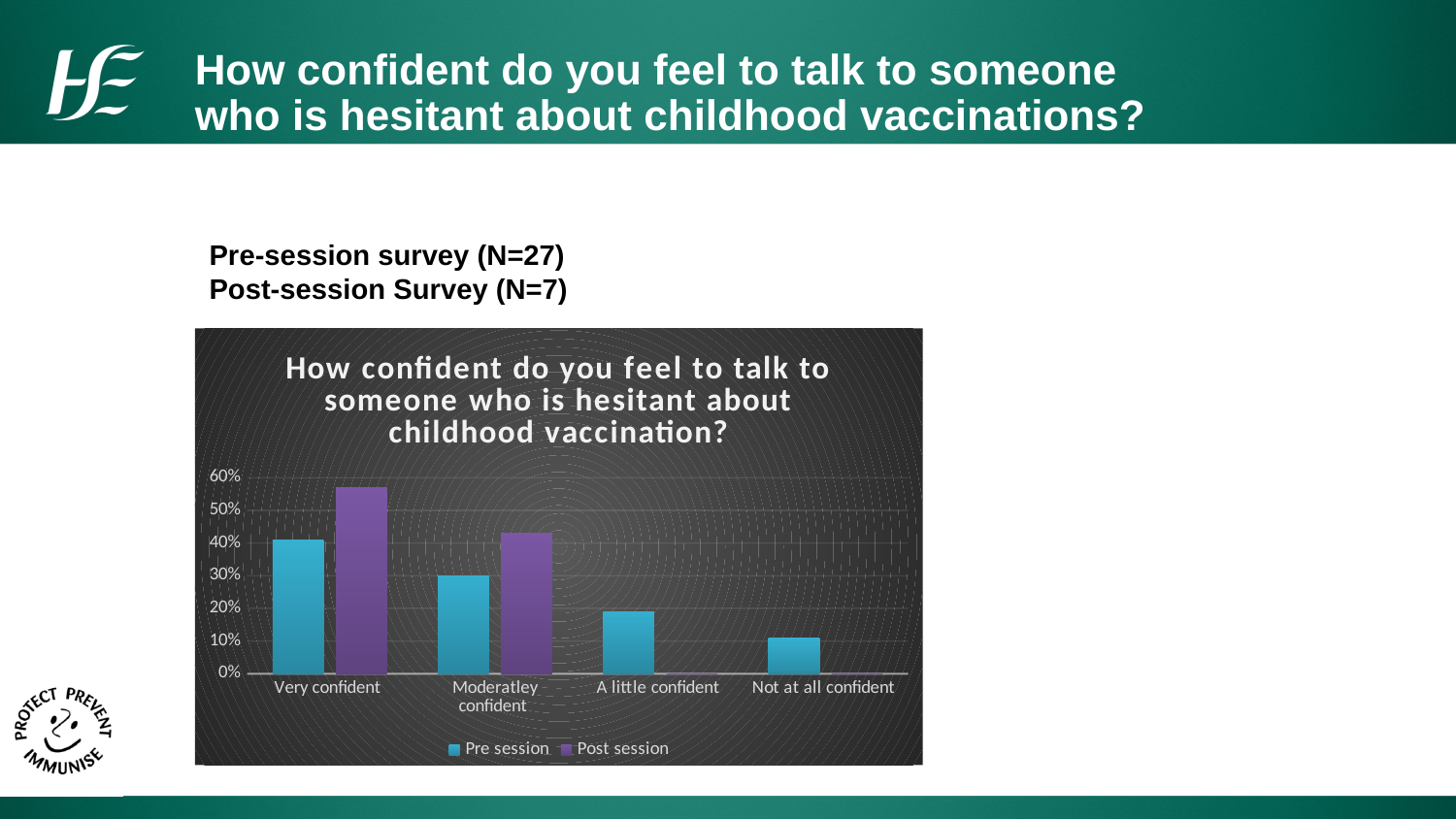
For the Very confident category, which series has the larger value, Pre session or Post session? Post session Which category has the lowest Pre session value? Not at all confident How many categories are shown on the x axis of the chart? 4 Is the Post session value for Moderatley confident greater or less than 40%? greater What are the two series named in the chart's legend? Pre session and Post session Do the Pre session values rise or fall moving from Very confident to Not at all confident along the x axis? fall How many series does the chart's legend list? 2 Which category has the highest Post session value? Very confident Which category has the highest Pre session value? Very confident Is the Post session value for Very confident greater or less than 50%? greater What kind of chart is shown on the slide? bar chart